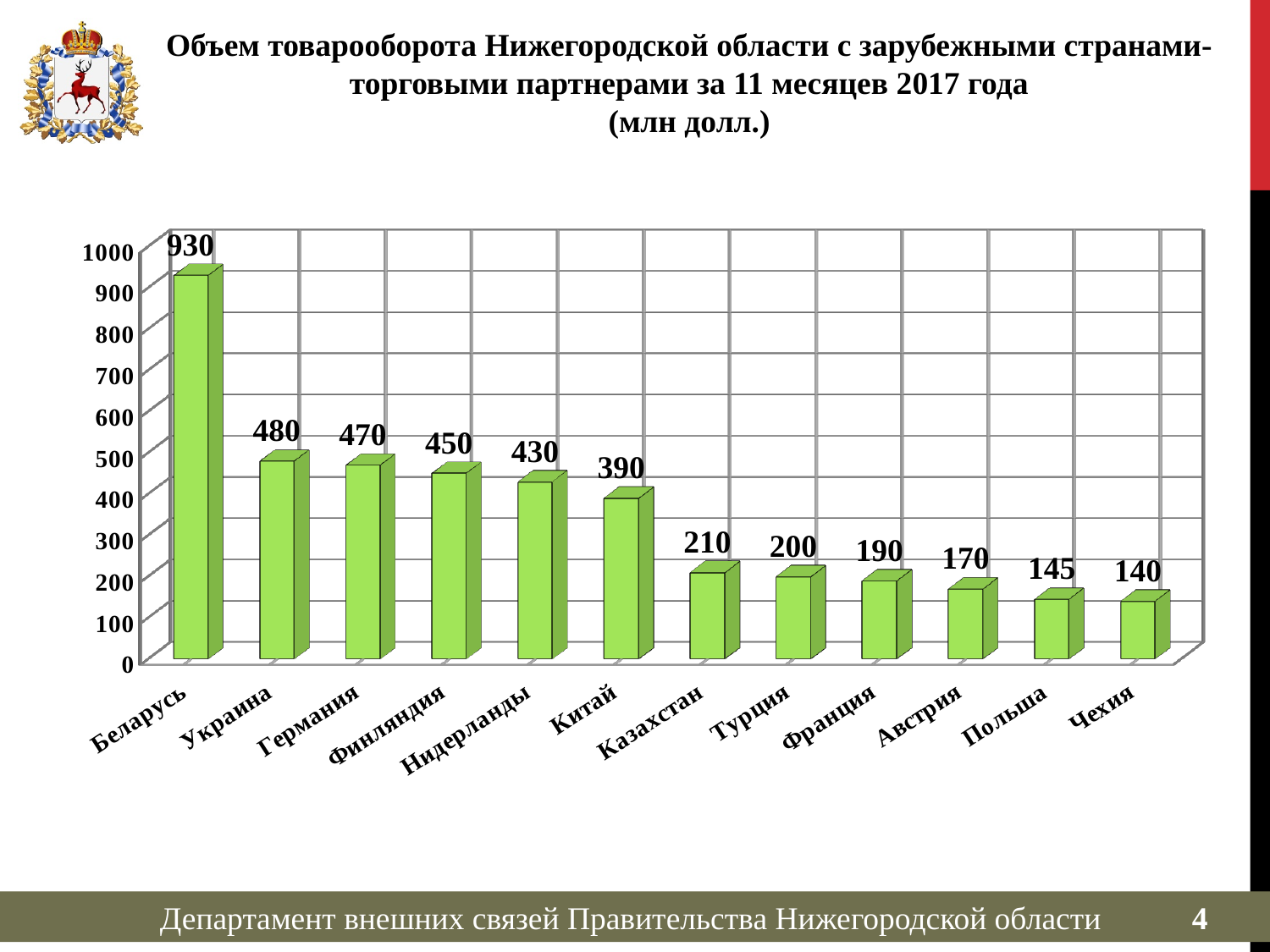
What is the value shown for Китай? 390 What is the value shown for Польша? 145 How many countries are shown on the chart? 12 What is the trade turnover value for Беларусь? 930 What is the difference between the values for Казахстан and Австрия? 40 Is the value for Финляндия greater or less than 400? greater What is the difference between the values for Беларусь and Украина? 450 Do the values rise or fall from left to right along the x axis? fall Which country has the highest trade turnover on the chart? Беларусь Which is larger, the value for Германия or the value for Нидерланды? Германия Which country has the lowest trade turnover on the chart? Чехия What kind of chart is shown on the slide? bar chart